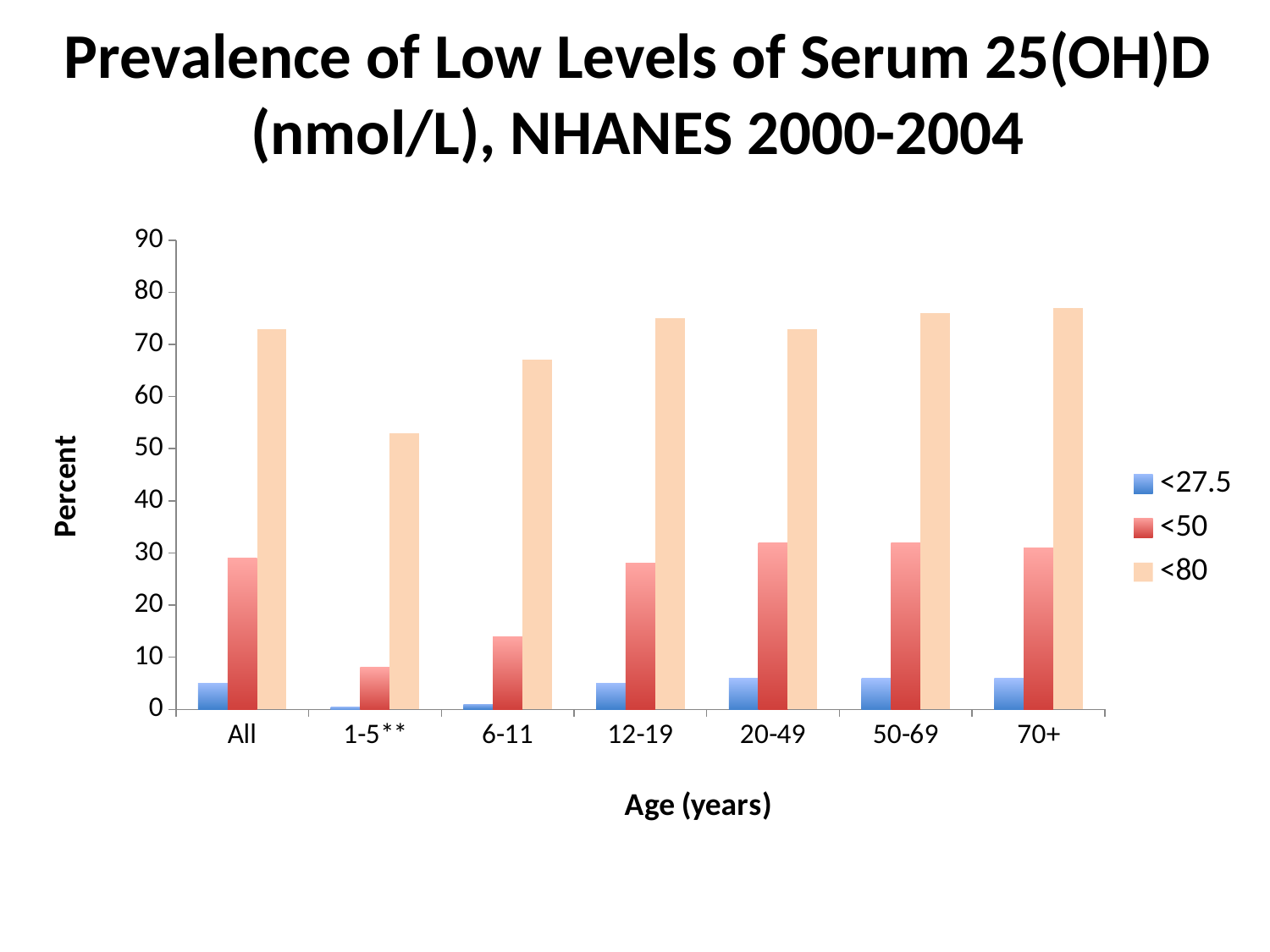
What kind of chart is shown on the slide? bar chart What is the title of the x axis? Age (years) How many series does the legend list? 3 Is the <80 value for the 1-5** age group greater or less than 60? less Is the <80 value for the 6-11 age group greater or less than 60? greater Is the <50 value for the All category greater or less than 20? greater Which age category has the lowest value for the <80 series? 1-5** For the <50 series, which is larger: the value for 12-19 or the value for 6-11? 12-19 How many age categories are shown on the x axis? 7 Which age category has the lowest value for the <50 series? 1-5** For the <80 series, which is larger: the value for 6-11 or the value for 1-5**? 6-11